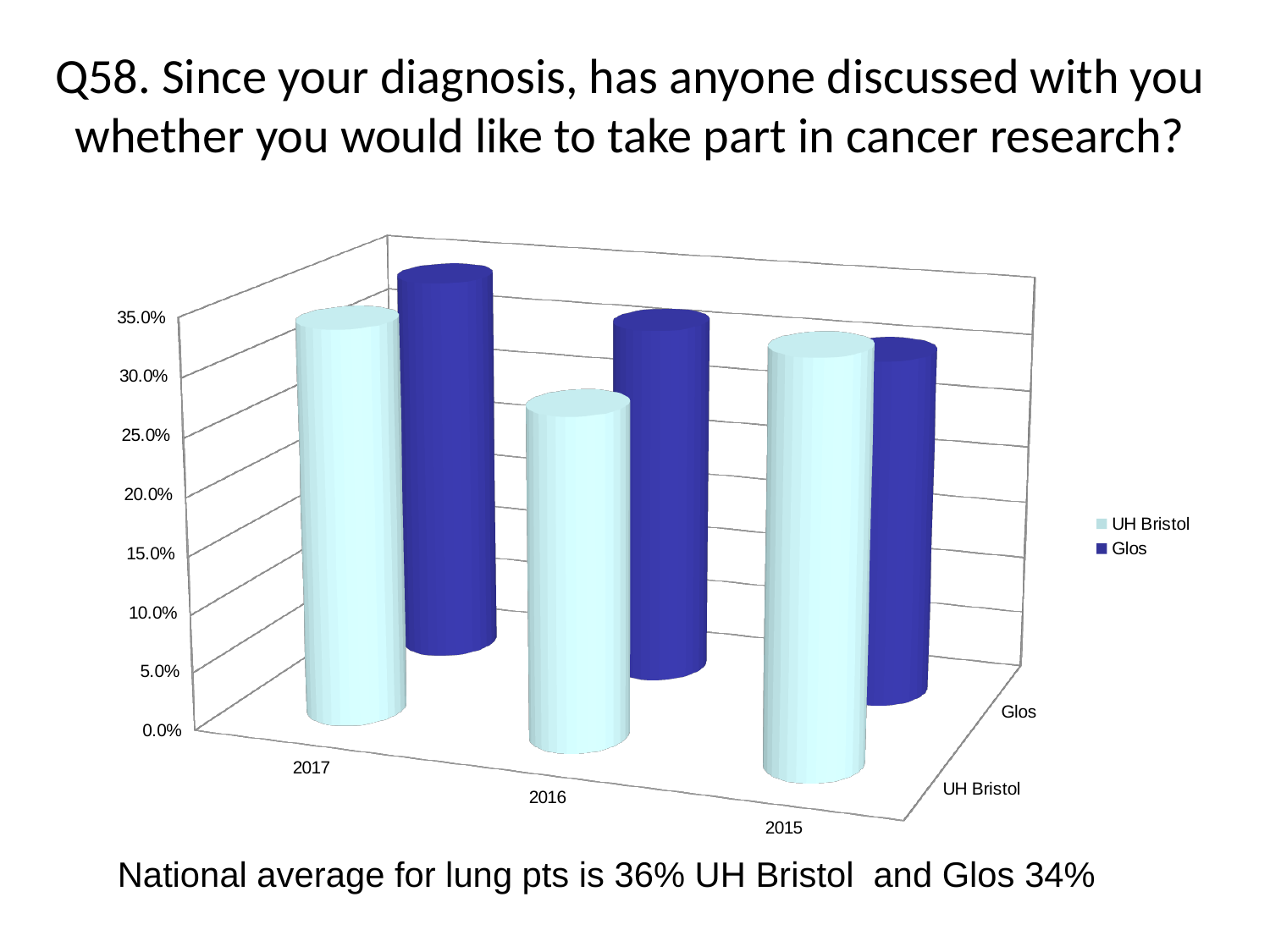
What kind of chart is shown on the slide? bar chart In which year is the UH Bristol value the lowest? 2016 Which is larger for UH Bristol, the 2017 value or the 2016 value? 2017 In which year is the Glos value the highest? 2017 According to the text below the chart, what is the national average for lung patients for Glos? 34% In which year is the Glos value the lowest? 2015 How many series does the legend list? 2 Is the UH Bristol value for 2016 greater or less than 25.0%? greater Which series are listed in the legend? UH Bristol and Glos How many years are shown along the x axis? 3 Is the Glos value for 2015 greater or less than 20.0%? greater